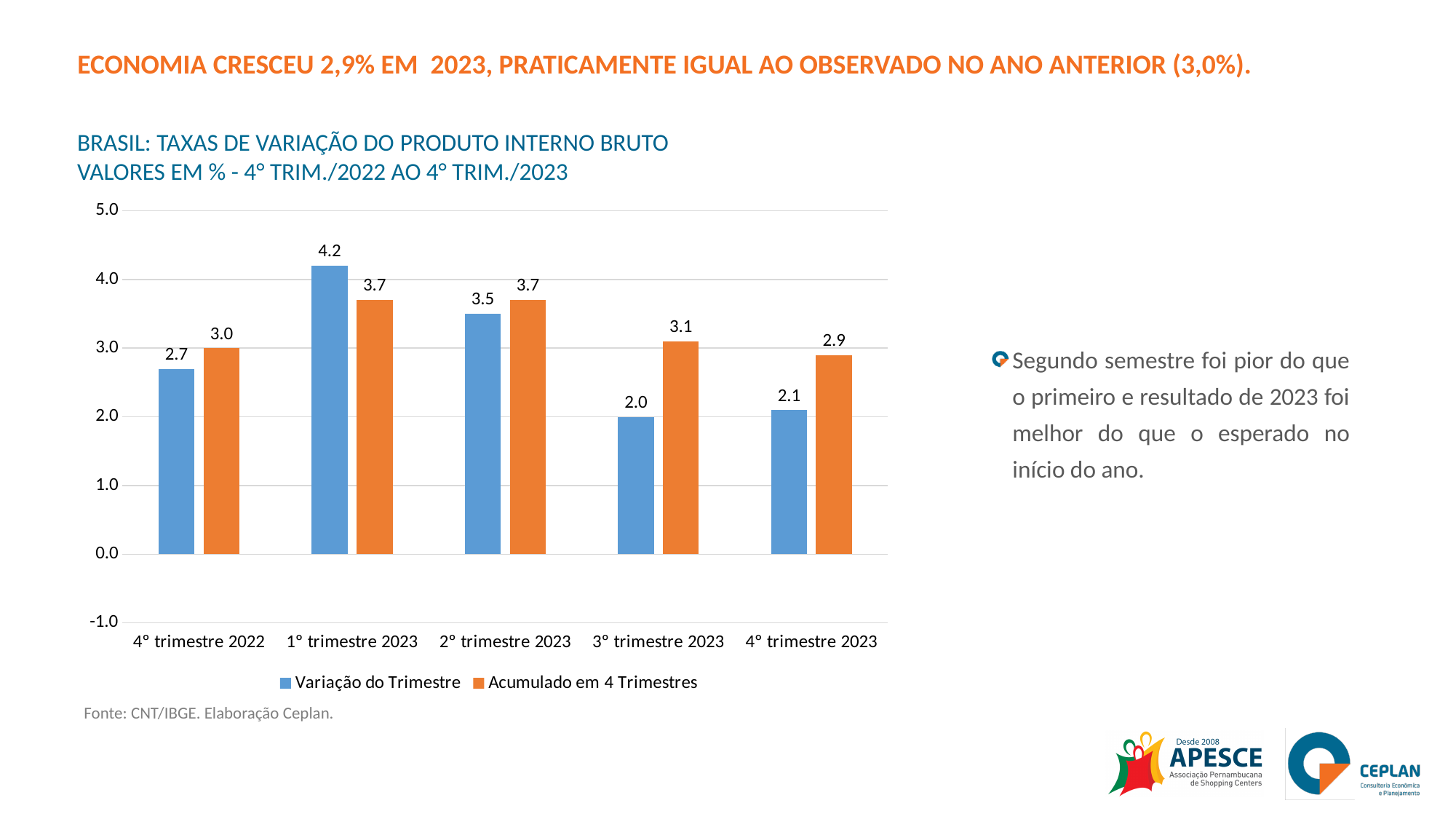
What is the value of Acumulado em 4 Trimestres for 4° trimestre 2023? 2.9 Which colour represents Acumulado em 4 Trimestres in the chart? Orange Which is larger for 4° trimestre 2022: Variação do Trimestre or Acumulado em 4 Trimestres? Acumulado em 4 Trimestres What is the value of Variação do Trimestre for 1° trimestre 2023? 4.2 Which quarter has the lowest Variação do Trimestre value? 3° trimestre 2023 What is the difference between Variação do Trimestre and Acumulado em 4 Trimestres for 1° trimestre 2023? 0.5 Which quarter has the highest Variação do Trimestre value? 1° trimestre 2023 What is the value of Variação do Trimestre for 3° trimestre 2023? 2.0 Is the Variação do Trimestre value for 2° trimestre 2023 greater or less than 3.0? greater What kind of chart is shown on the slide? Bar chart How many series does the legend list? 2 How many quarters are shown on the x axis? 5